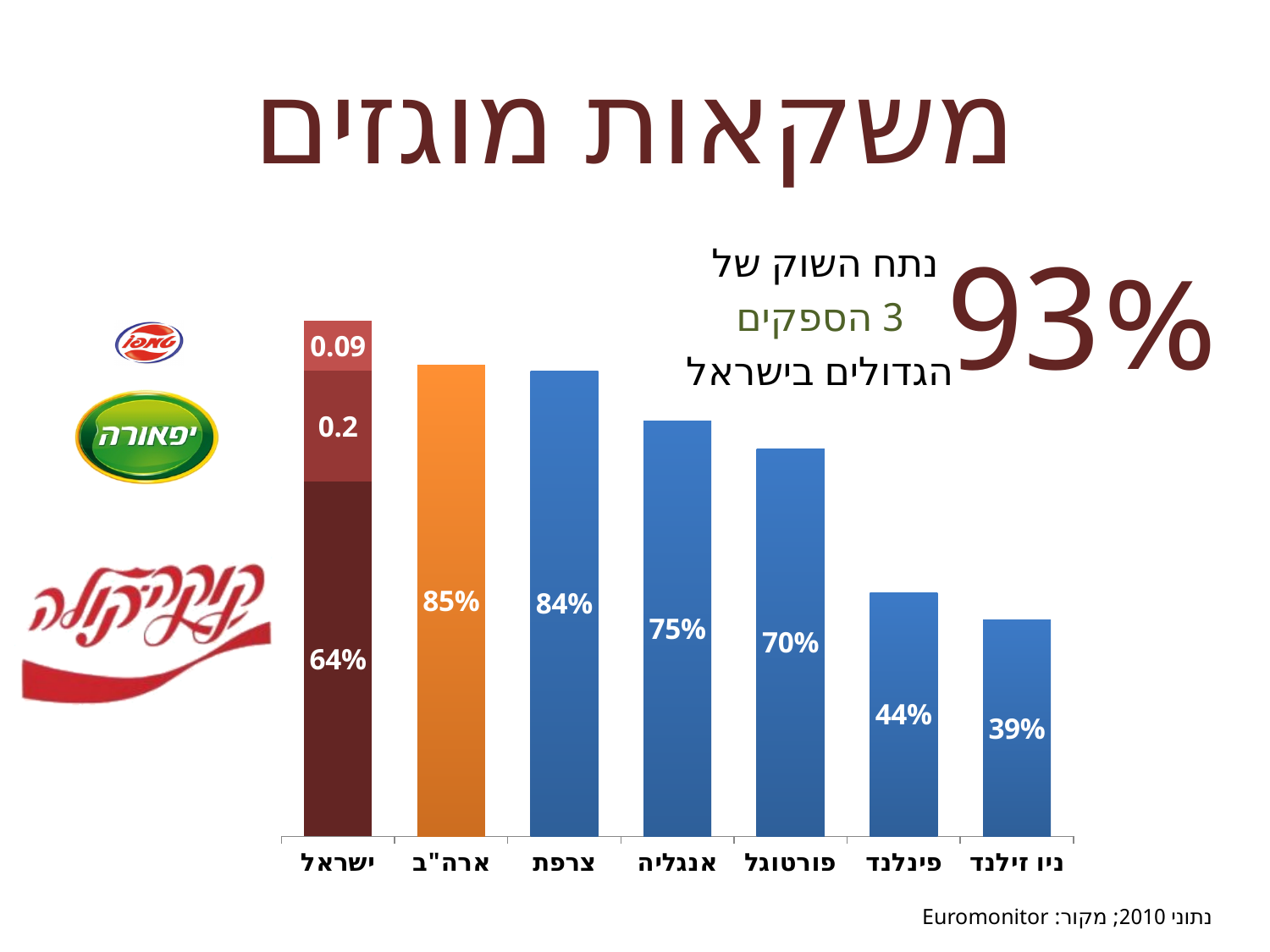
Which country has the lowest value in the chart? ניו זילנד (New Zealand) What is the value labelled on the top segment of the ישראל (Israel) bar? 0.09 What is the value shown for ארה"ב (USA)? 85% What is the value shown for אנגליה (England)? 75% What is the value shown for פורטוגל (Portugal)? 70% Which is larger, the value for אנגליה (England) or the value for פורטוגל (Portugal)? אנגליה (England) What is the value shown for צרפת (France)? 84% How many countries are shown on the x axis of the chart? 7 What kind of chart is shown on the slide? Bar chart What is the value labelled on the bottom (dark red) segment of the ישראל (Israel) bar? 64% What is the difference between the values for פינלנד (Finland) and ניו זילנד (New Zealand)? 5% Which single-segment bar has the highest value in the chart? ארה"ב (USA)